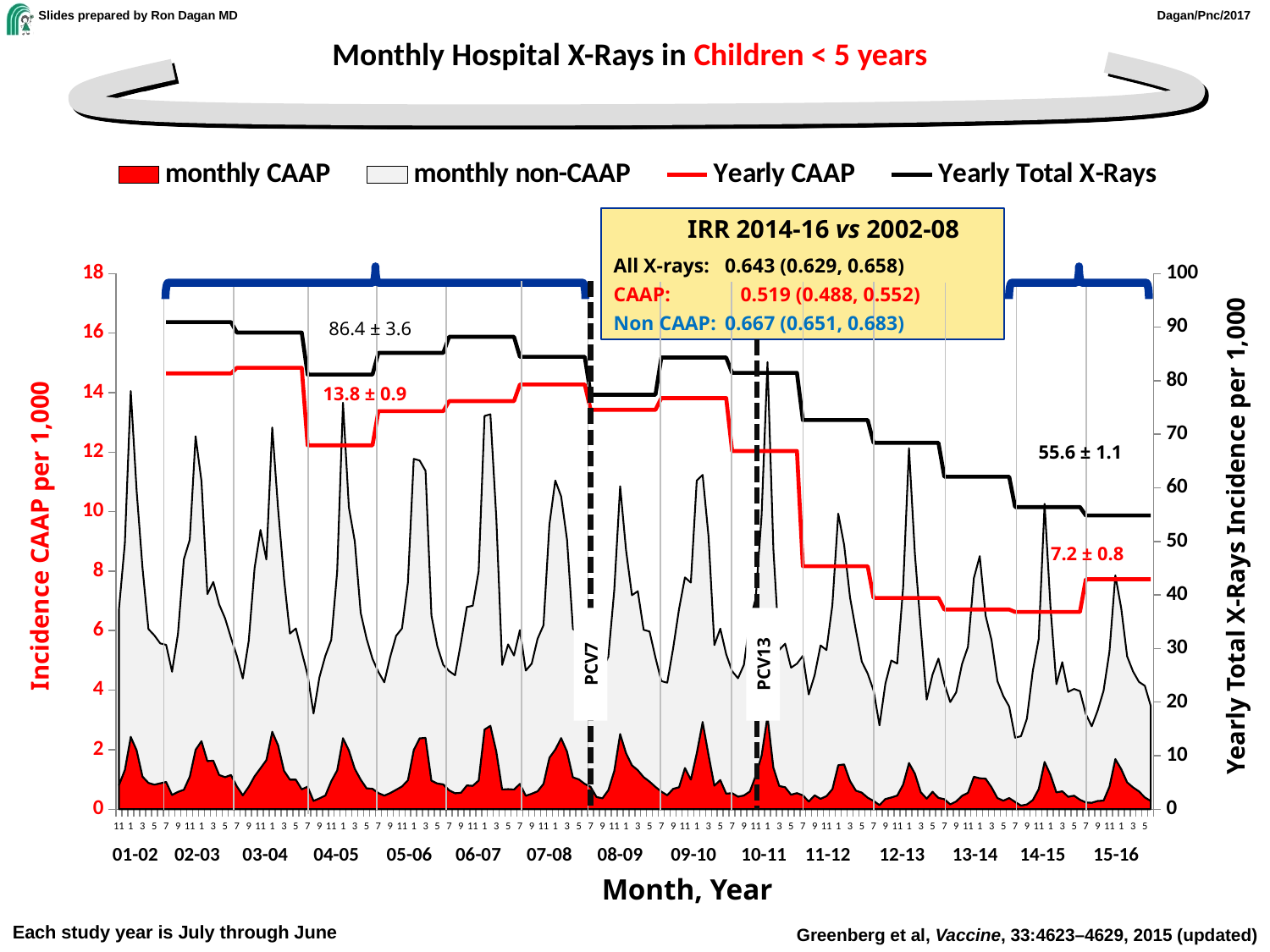
How many study years are labelled along the x axis? 15 What mean value is annotated for Yearly Total X-Rays in the early pre-PCV period? 86.4 ± 3.6 What mean value is annotated for Yearly CAAP in the 2014-16 period? 7.2 ± 0.8 Does the Yearly Total X-Rays line rise or fall from 01-02 to 15-16? fall What is the IRR for All X-rays for 2014-16 vs 2002-08 shown in the box? 0.643 (0.629, 0.658) Which vaccine introduction is marked by the first dashed vertical line? PCV7 What is the IRR for CAAP for 2014-16 vs 2002-08 shown in the box? 0.519 (0.488, 0.552) Which is higher, the Yearly CAAP value in 01-02 or in 15-16? 01-02 What mean value is annotated for Yearly Total X-Rays in the 2014-16 period? 55.6 ± 1.1 Is the Yearly Total X-Rays value in 15-16 greater or less than 60 on the right axis? less How many series does the legend list? 4 What mean value is annotated for Yearly CAAP in the early pre-PCV period? 13.8 ± 0.9